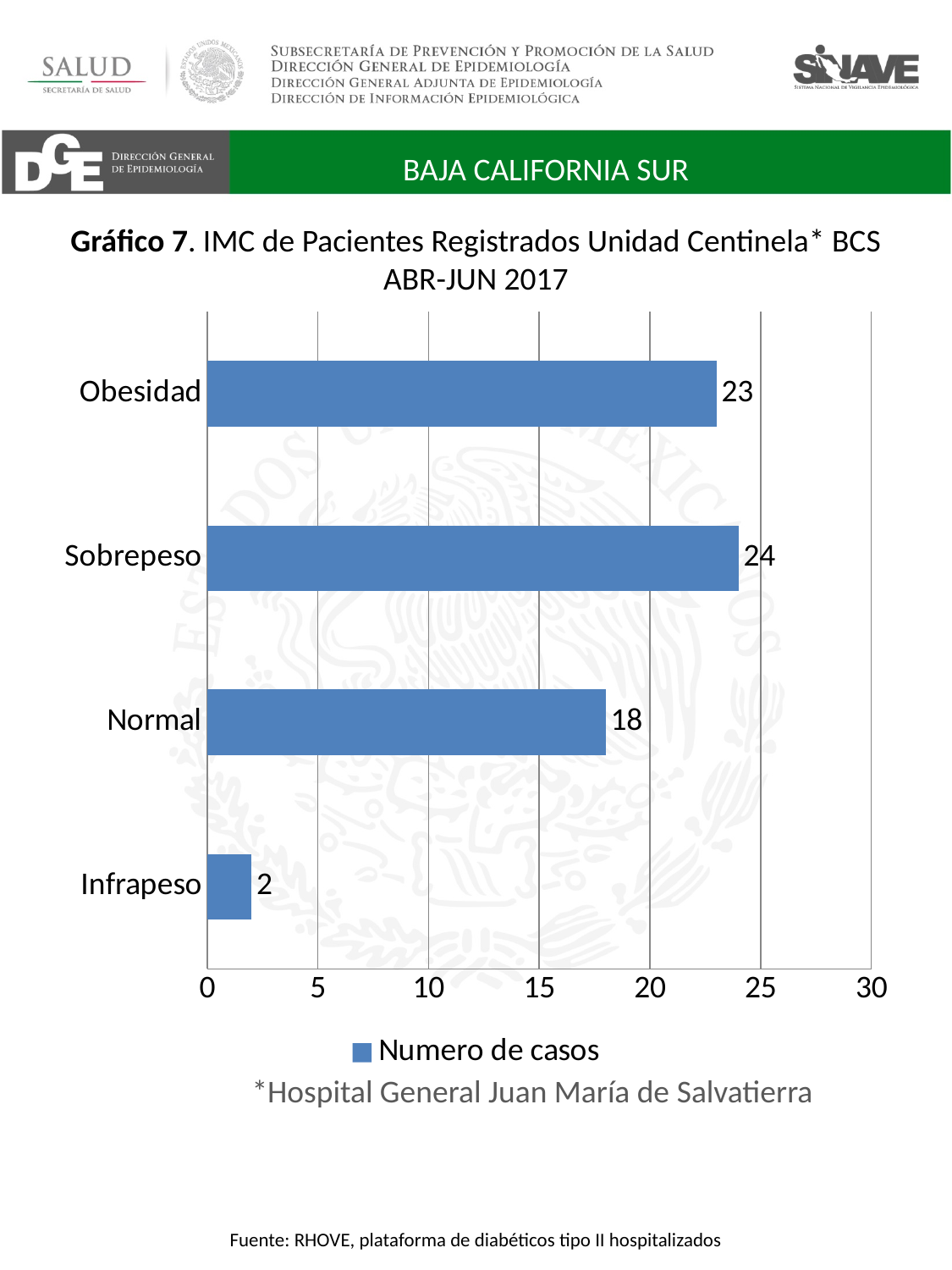
What is the difference in number of cases between Sobrepeso and Normal? 6 How many BMI categories are shown in the chart? 4 Which BMI category has the lowest number of cases? Infrapeso What is the number of cases for Obesidad? 23 Which has more cases, Obesidad or Normal? Obesidad What is the difference in number of cases between Obesidad and Infrapeso? 21 Which BMI category has the highest number of cases? Sobrepeso What kind of chart is shown on the slide? Bar chart What is the number of cases for Normal? 18 What is the number of cases for Sobrepeso? 24 What is the number of cases for Infrapeso? 2 What is the legend entry for the series shown in the chart? Numero de casos